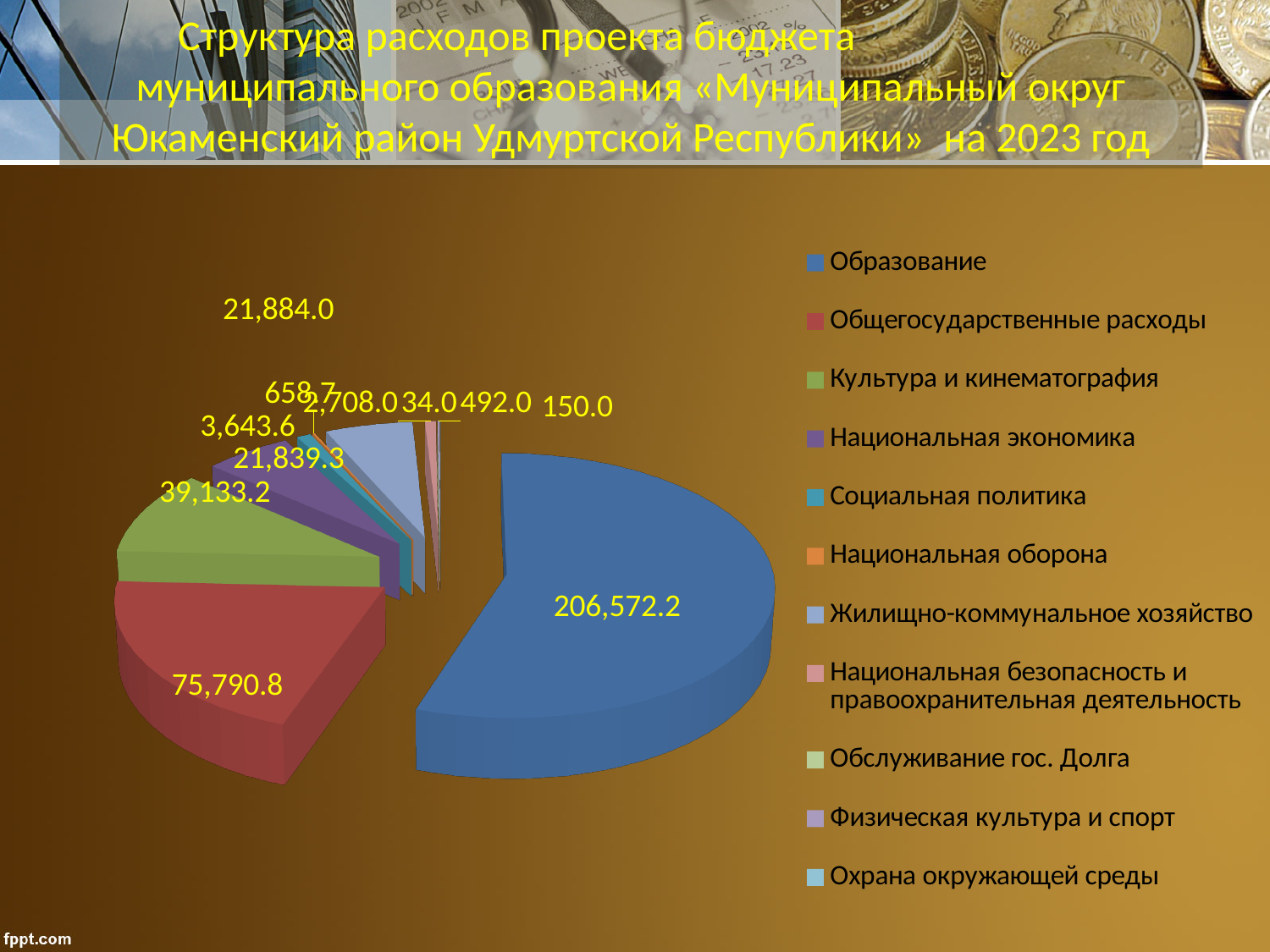
For which year does the chart show the budget expenditure structure? 2023 What is the value shown for Общегосударственные расходы? 75,790.8 What is the difference between the values for Культура и кинематография and Национальная экономика? 17,293.9 What kind of chart is shown on the slide? pie chart What is the smallest value labelled on the pie chart? 34.0 Which is larger, the value for Общегосударственные расходы or the value for Культура и кинематография? Общегосударственные расходы Which category has the largest slice of the pie? Образование What is the value shown for Национальная экономика? 21,839.3 What is the difference between the values for Образование and Общегосударственные расходы? 130,781.4 How many categories does the legend of the pie chart list? 11 What is the value shown for Культура и кинематография? 39,133.2 What is the value shown for Образование? 206,572.2